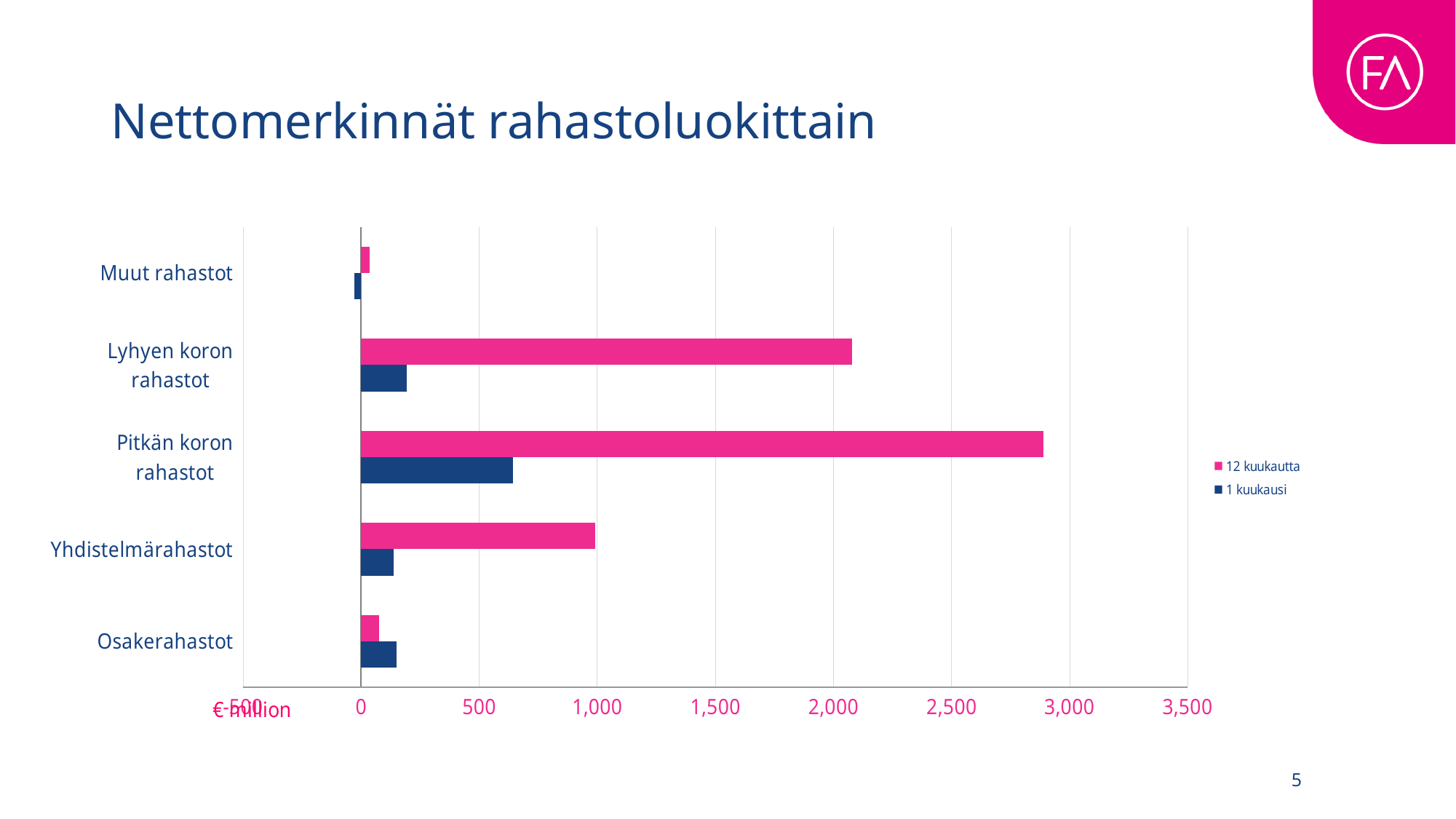
What kind of chart is shown on the slide? bar chart Which category has the highest value for the 12 kuukautta series? Pitkän koron rahastot Which category has the lowest value for the 12 kuukautta series? Muut rahastot What is the title of the chart on the slide? Nettomerkinnät rahastoluokittain Is the 12 kuukautta value for Pitkän koron rahastot greater or less than 2,500? greater Which category has the lowest value for the 1 kuukausi series? Muut rahastot How many series does the chart's legend list? 2 Which category has the highest value for the 1 kuukausi series? Pitkän koron rahastot Is the 12 kuukautta value for Lyhyen koron rahastot greater or less than 2,500? less How many fund categories are shown on the y axis of the chart? 5 Is the 1 kuukausi value for Pitkän koron rahastot greater or less than 500? greater For Osakerahastot, which series has the larger value: 12 kuukautta or 1 kuukausi? 1 kuukausi